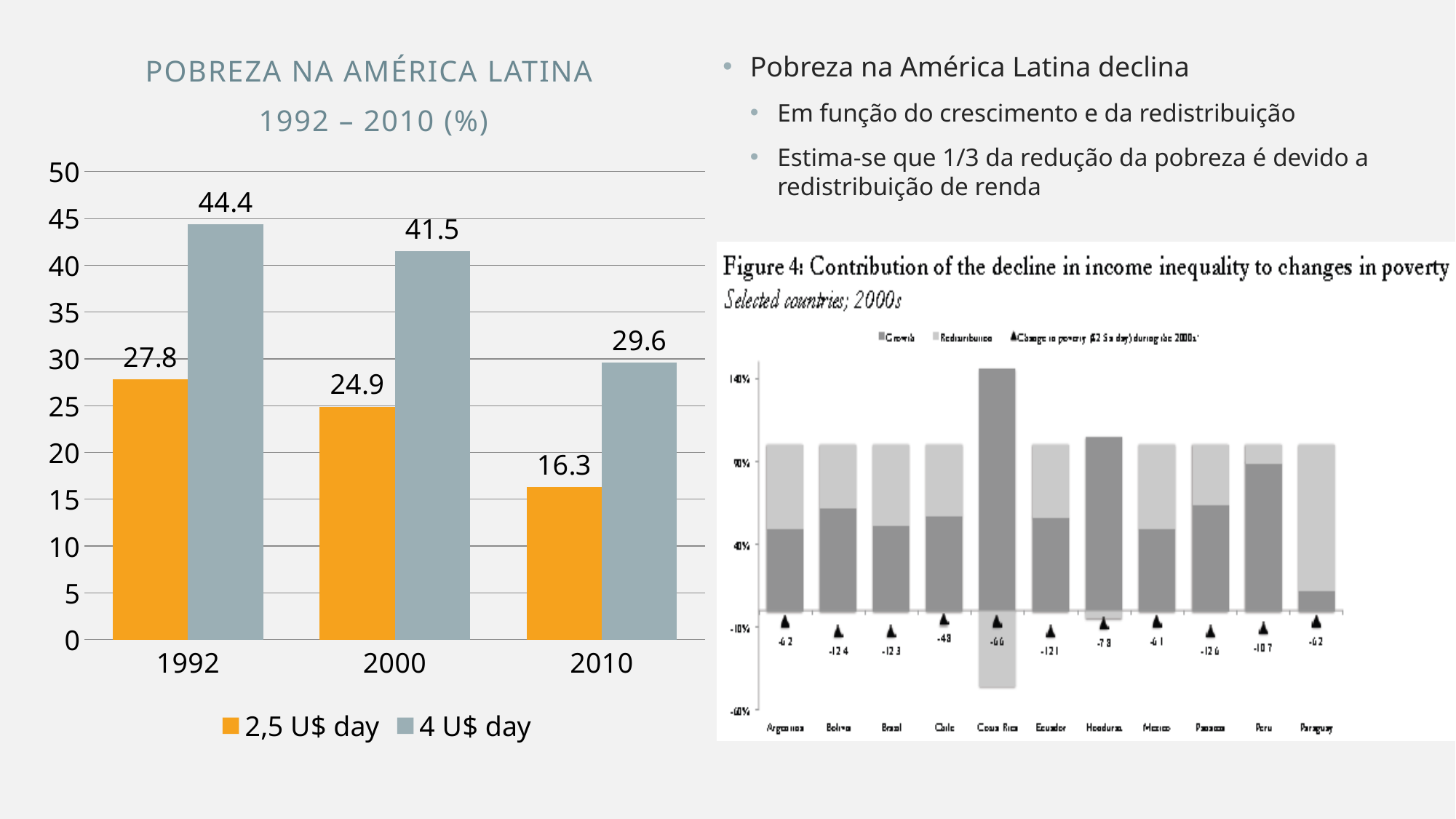
In the chart 'POBREZA NA AMÉRICA LATINA 1992 – 2010 (%)', what is the value for '2,5 U$ day' in 1992? 27.8 In the chart 'POBREZA NA AMÉRICA LATINA 1992 – 2010 (%)', how many years are shown on the x axis? 3 What kind of chart is 'POBREZA NA AMÉRICA LATINA 1992 – 2010 (%)'? Bar chart In the chart 'POBREZA NA AMÉRICA LATINA 1992 – 2010 (%)', which is larger: '2,5 U$ day' in 1992 or '4 U$ day' in 2010? 4 U$ day in 2010 In the chart 'POBREZA NA AMÉRICA LATINA 1992 – 2010 (%)', what is the value for '4 U$ day' in 2010? 29.6 In the chart 'POBREZA NA AMÉRICA LATINA 1992 – 2010 (%)', how many series does the legend list? 2 In the chart 'POBREZA NA AMÉRICA LATINA 1992 – 2010 (%)', which year has the highest value for '4 U$ day'? 1992 In the chart 'POBREZA NA AMÉRICA LATINA 1992 – 2010 (%)', by how much did the '4 U$ day' value fall from 1992 to 2010? 14.8 In the chart 'POBREZA NA AMÉRICA LATINA 1992 – 2010 (%)', which year has the lowest value for '2,5 U$ day'? 2010 In the chart 'POBREZA NA AMÉRICA LATINA 1992 – 2010 (%)', which series is shown in orange? 2,5 U$ day In the chart 'POBREZA NA AMÉRICA LATINA 1992 – 2010 (%)', what is the difference between the '4 U$ day' and '2,5 U$ day' values in 2000? 16.6 In the chart 'POBREZA NA AMÉRICA LATINA 1992 – 2010 (%)', do the '2,5 U$ day' values rise or fall from 1992 to 2010? Fall